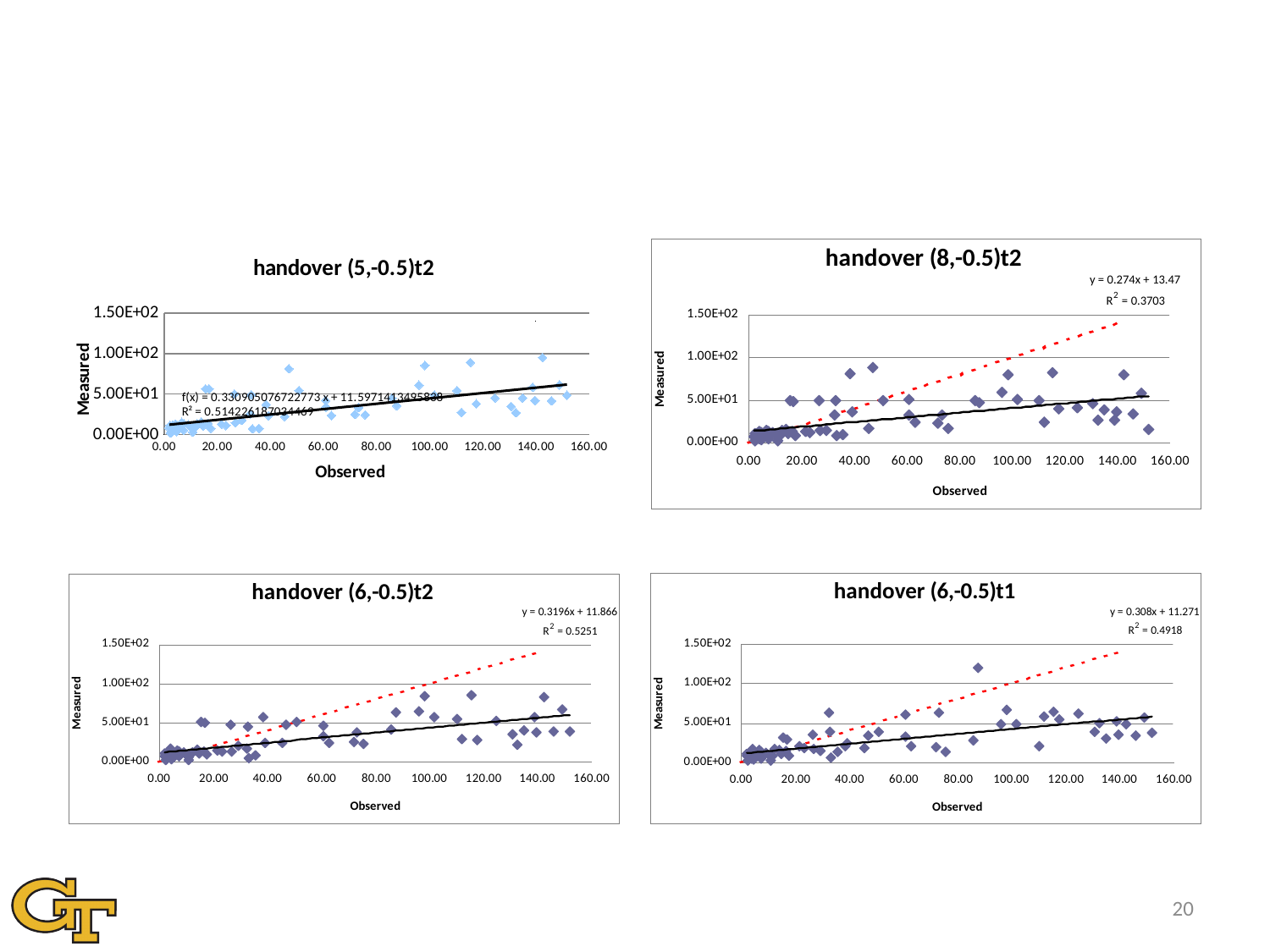
In the chart "handover (6,-0.5)t2", do the Measured values generally rise or fall as Observed increases? rise What is the maximum tick value shown on the y axis of the chart "handover (6,-0.5)t1"? 1.50E+02 How many charts are shown on the slide? 4 In the chart "handover (6,-0.5)t1", is the highest plotted point greater or less than 1.00E+02 on the Measured axis? greater Which chart has the higher printed R² value, "handover (6,-0.5)t2" or "handover (8,-0.5)t2"? handover (6,-0.5)t2 In the chart "handover (6,-0.5)t1", what R² value is printed? R² = 0.4918 In the chart "handover (6,-0.5)t2", what is the trendline equation printed on the chart? y = 0.3196x + 11.866 In the chart "handover (8,-0.5)t2", what R² value is printed? R² = 0.3703 What kind of chart is "handover (8,-0.5)t2"? scatter chart In the chart "handover (8,-0.5)t2", what is the trendline equation printed on the chart? y = 0.274x + 13.47 What is the label of the x axis in the chart "handover (5,-0.5)t2"? Observed Which chart has the larger printed trendline slope, "handover (6,-0.5)t1" or "handover (8,-0.5)t2"? handover (6,-0.5)t1